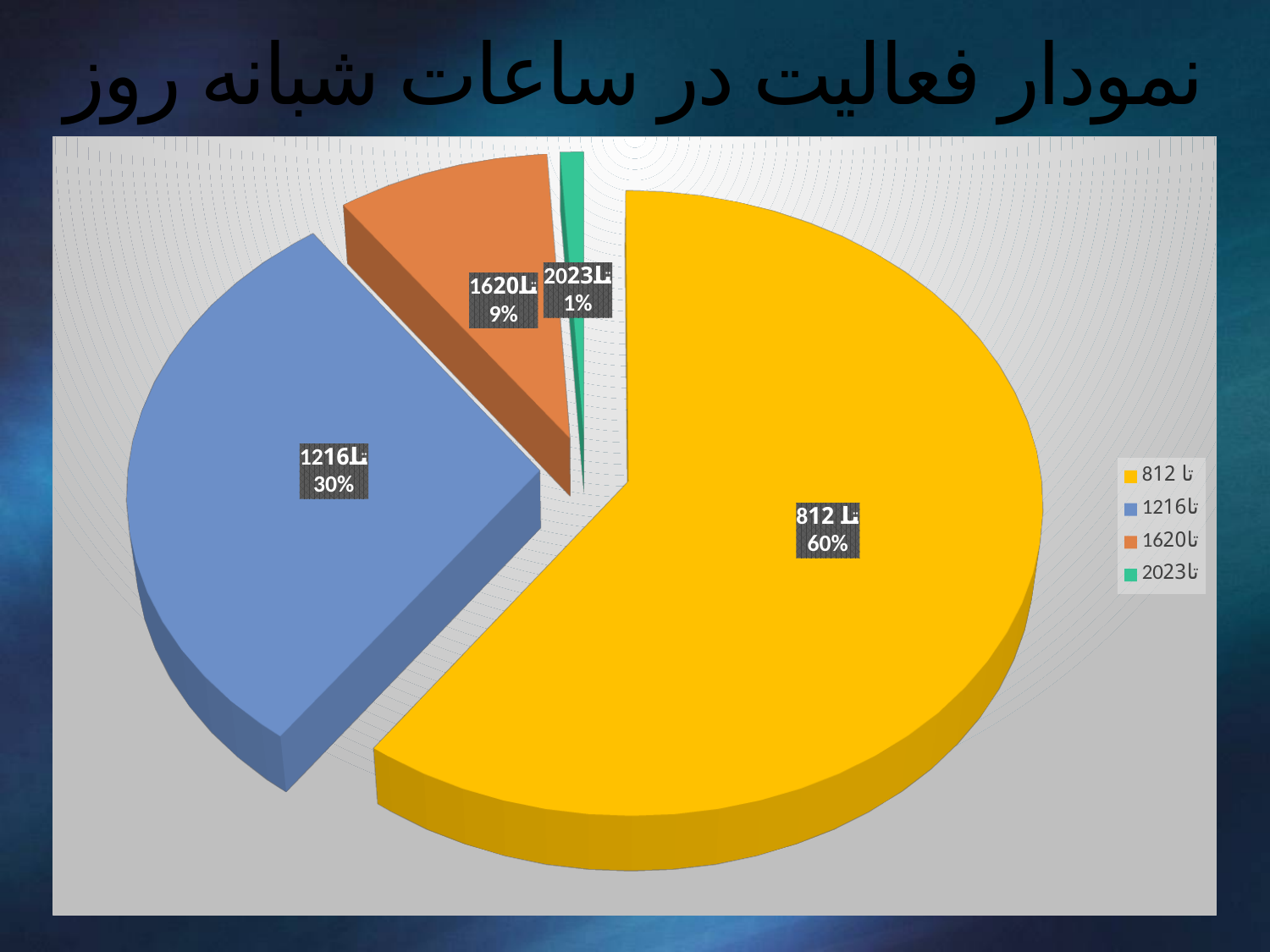
What is the title of the slide? نمودار فعالیت در ساعات شبانه روز How many slices does the pie chart have? 4 What percentage is shown for the slice labelled "812 تا"? 60% What percentage is shown for the slice labelled "2023تا"? 1% What percentage is shown for the slice labelled "1620تا"? 9% What colour is the slice labelled "1216تا"? blue What is the difference in percentage points between the "812 تا" slice and the "1216تا" slice? 30 What percentage is shown for the slice labelled "1216تا"? 30% Which slice of the pie chart is the smallest? 2023تا Which slice is larger, "1620تا" or "2023تا"? 1620تا Which slice of the pie chart is the largest? 812 تا What type of chart is shown on the slide? pie chart